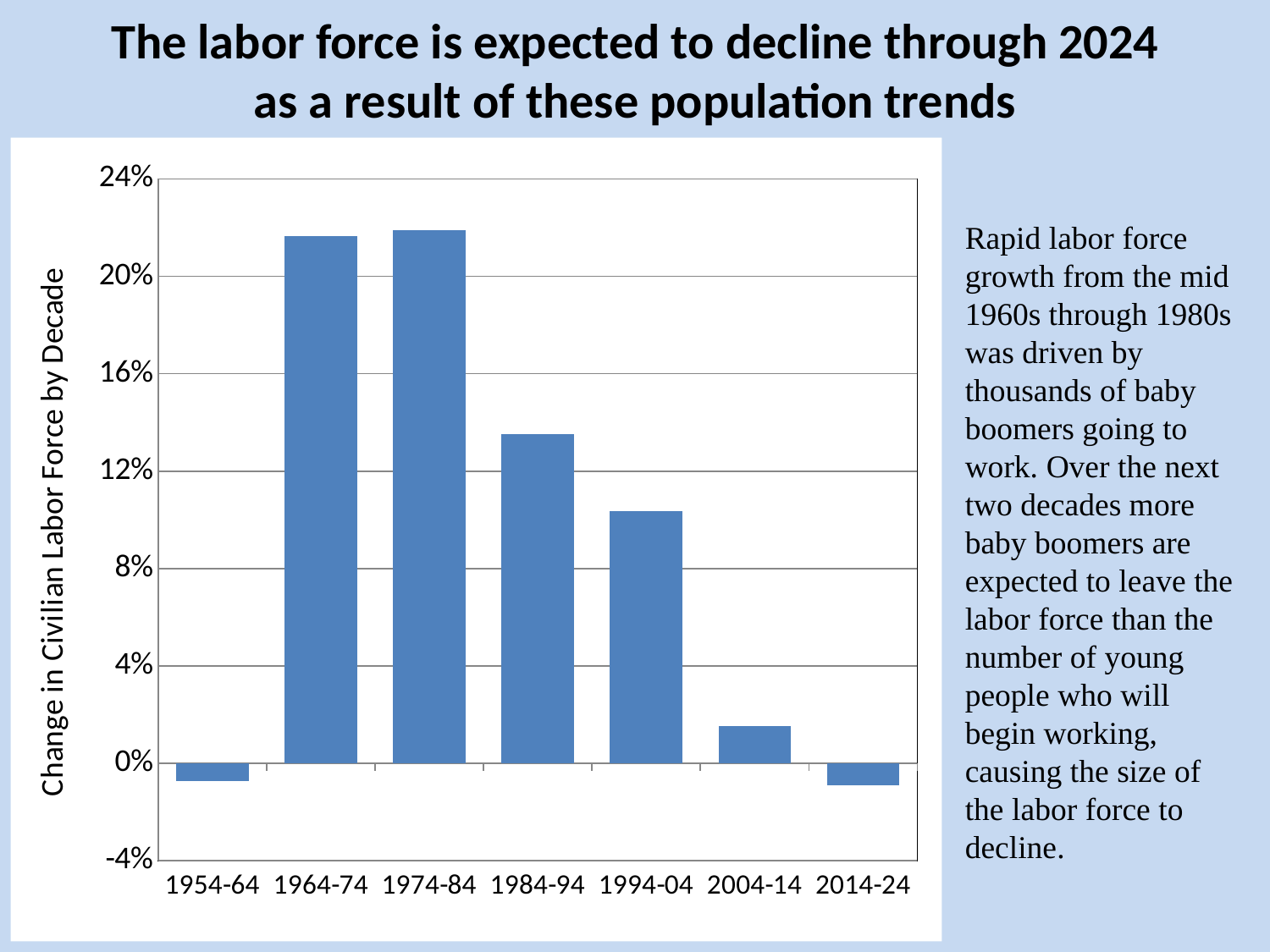
How many decade categories are shown on the x axis of the chart? 7 Is the value for 1994-04 greater or less than 8%? greater What is the label on the vertical axis of the chart? Change in Civilian Labor Force by Decade What kind of chart is shown on the slide? bar chart From 1974-84 onward, do the values rise or fall along the x axis? fall Is the value for 2004-14 greater or less than 4%? less Which has the larger value, 2004-14 or 1974-84? 1974-84 Is the value for 1994-04 greater or less than 12%? less Which has the larger value, 1984-94 or 1994-04? 1984-94